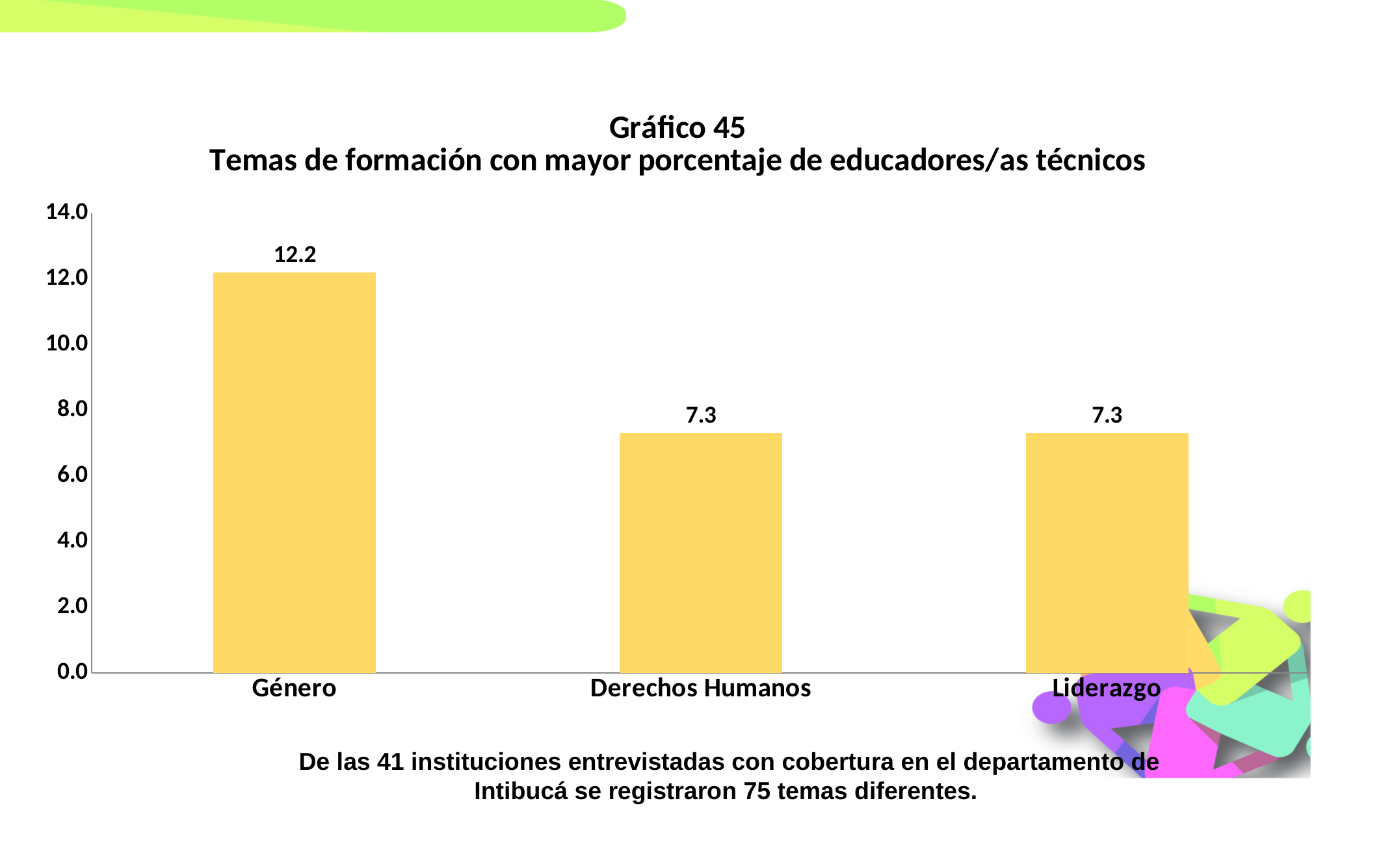
What is the value for Género? 12.2 How many categories are shown on the x axis? 3 Is the value for Género greater or less than 10.0? greater What is the title of the chart? Gráfico 45 Temas de formación con mayor porcentaje de educadores/as técnicos What kind of chart is shown on the slide? bar chart Which is larger, the value for Género or the value for Liderazgo? Género What is the value for Liderazgo? 7.3 What is the highest value shown on the y axis? 14.0 Which category has the highest value? Género What is the value for Derechos Humanos? 7.3 What is the difference between the values for Género and Derechos Humanos? 4.9 Is the value for Derechos Humanos greater or less than 8.0? less